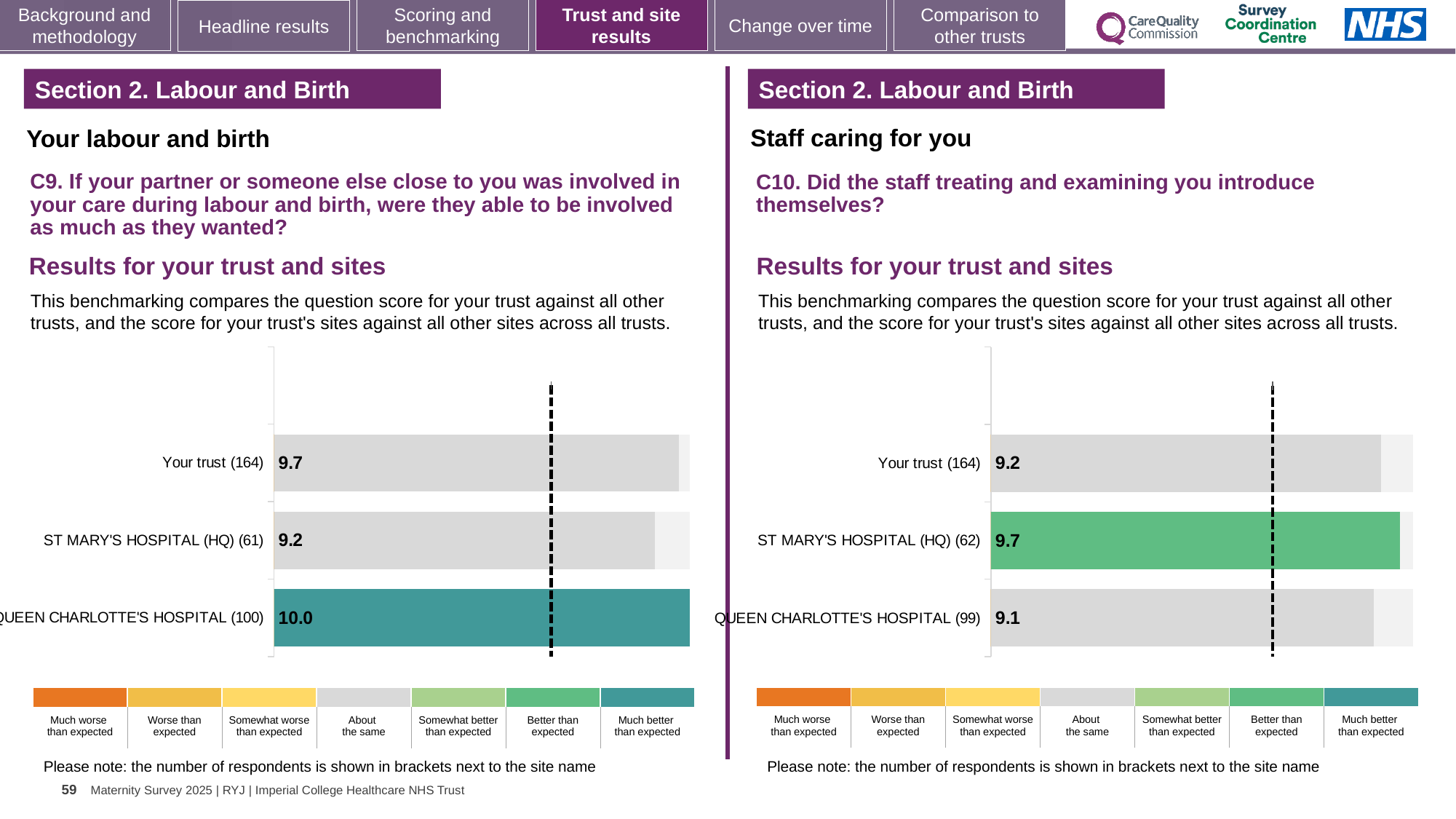
In the right chart (C10), which is larger: the score for Your trust (164) or for QUEEN CHARLOTTE'S HOSPITAL (99)? Your trust (164) In the right chart (C10), which benchmark category does the colour of the ST MARY'S HOSPITAL (HQ) (62) bar correspond to in the legend? Better than expected In the left chart (C9), what is the score for Your trust (164)? 9.7 In the left chart (C9), what is the difference between the scores for QUEEN CHARLOTTE'S HOSPITAL (100) and ST MARY'S HOSPITAL (HQ) (61)? 0.8 In the left chart (C9), what is the score for QUEEN CHARLOTTE'S HOSPITAL (100)? 10.0 In the right chart (C10), which site or trust has the highest score? ST MARY'S HOSPITAL (HQ) (62) How many bars are plotted in the left chart (C9)? 3 What type of chart is used in the right chart (C10)? Bar chart In the right chart (C10), what is the score for ST MARY'S HOSPITAL (HQ) (62)? 9.7 In the right chart (C10), what is the difference between the scores for ST MARY'S HOSPITAL (HQ) (62) and Your trust (164)? 0.5 In the left chart (C9), which site or trust has the lowest score? ST MARY'S HOSPITAL (HQ) (61) In the right chart (C10), what is the score for QUEEN CHARLOTTE'S HOSPITAL (99)? 9.1